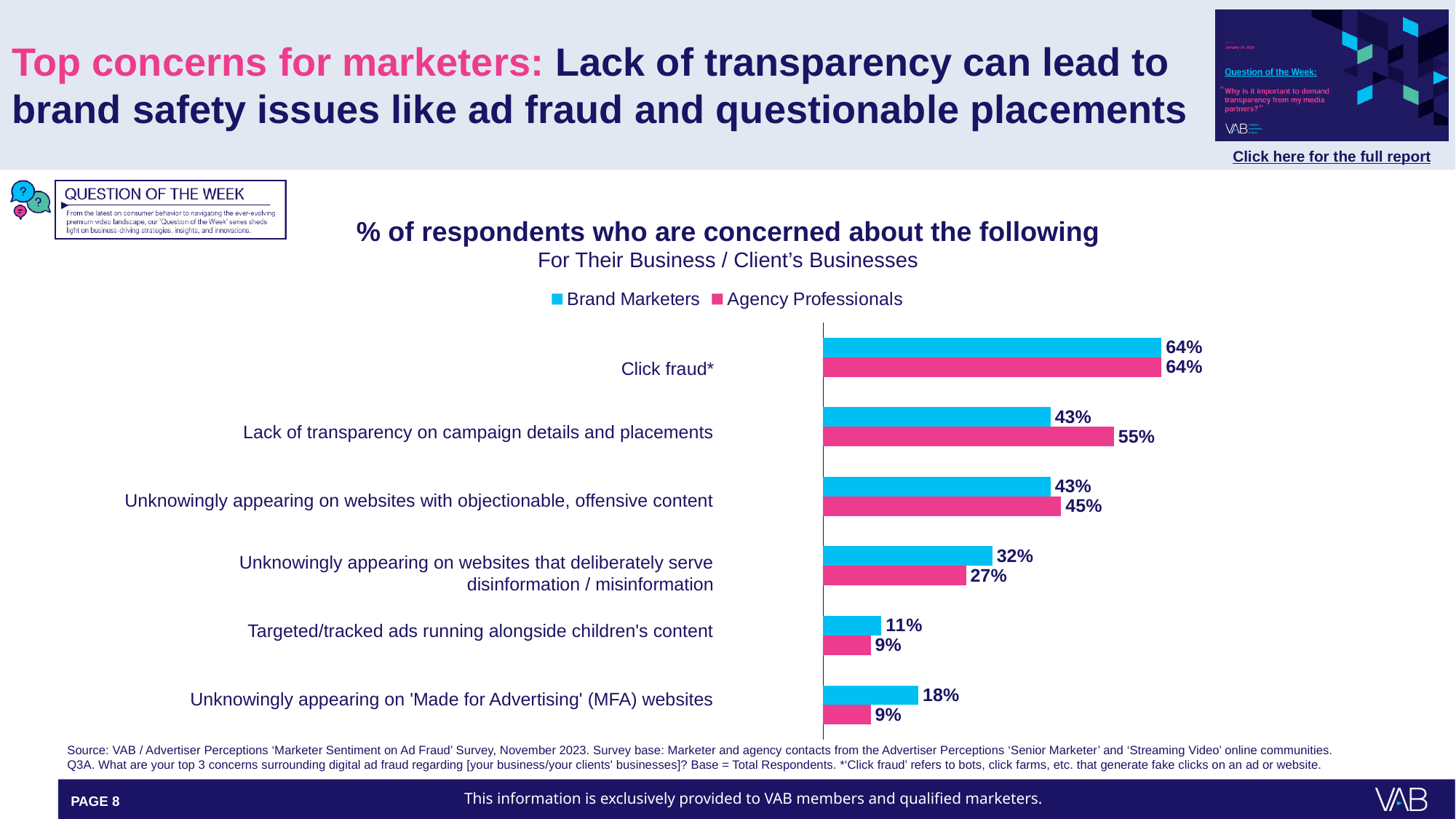
How many concerns (categories) are shown in the chart? 6 Which concern has the highest percentage among Agency Professionals? Click fraud* What is the difference between Agency Professionals and Brand Marketers for lack of transparency on campaign details and placements? 12 percentage points What is the difference between Brand Marketers and Agency Professionals for targeted/tracked ads running alongside children's content? 2 percentage points What percentage of Agency Professionals are concerned about lack of transparency on campaign details and placements? 55% What type of chart is shown on the slide? Bar chart Which colour represents Agency Professionals in the chart? Pink What percentage of Brand Marketers are concerned about unknowingly appearing on 'Made for Advertising' (MFA) websites? 18% Which concern has the lowest percentage among Brand Marketers? Targeted/tracked ads running alongside children's content What percentage of Brand Marketers are concerned about click fraud? 64% For unknowingly appearing on websites that deliberately serve disinformation / misinformation, which group has the higher percentage: Brand Marketers or Agency Professionals? Brand Marketers How many series does the legend list? 2